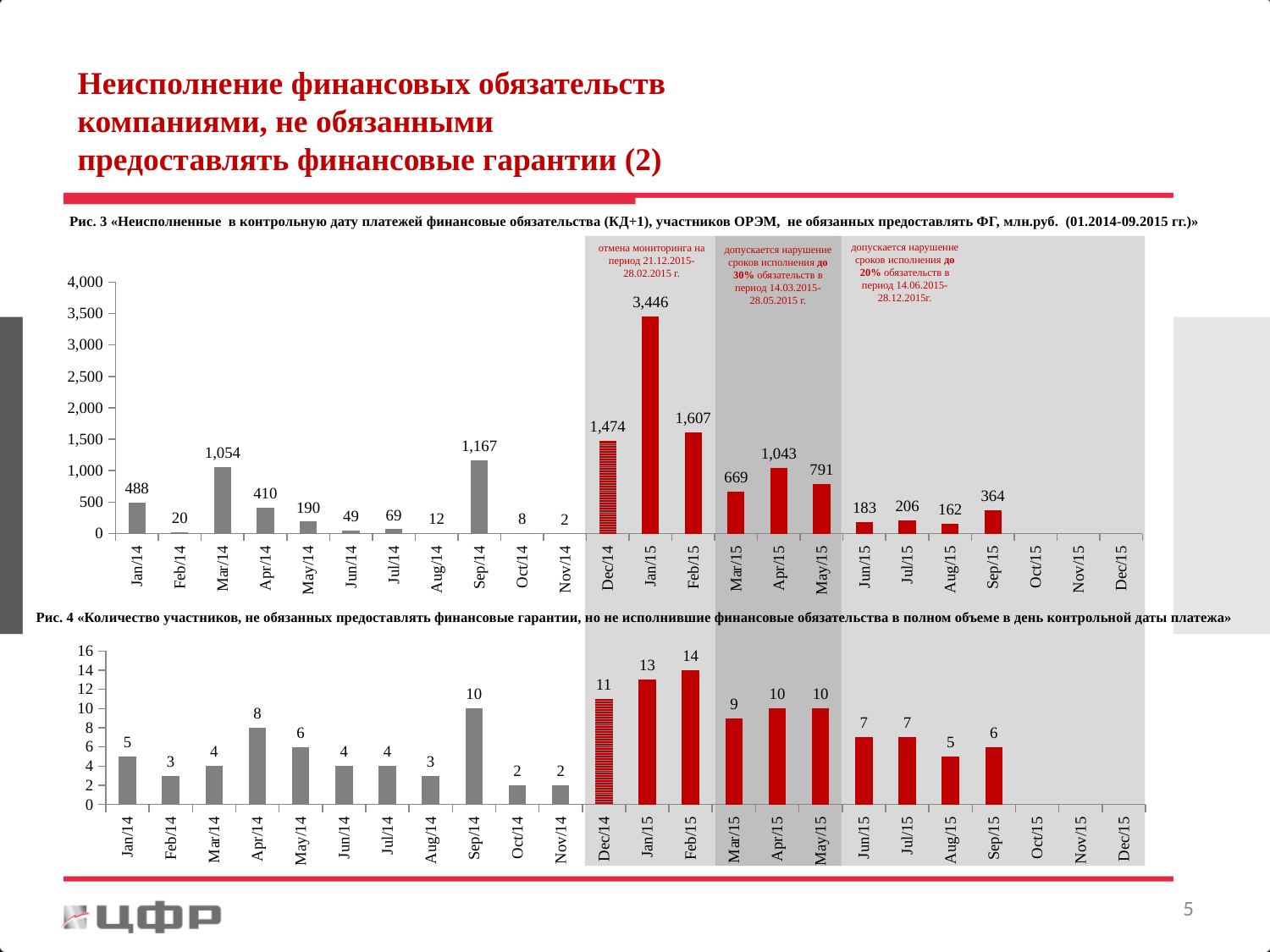
In the top chart (Рис. 3), what is the value for Jan/15? 3,446 In the bottom chart (Рис. 4), which month has the highest value? Feb/15 In the top chart (Рис. 3), which month has the lowest value among the months with a data label? Nov/14 In the bottom chart (Рис. 4), what is the difference between the values for Jan/15 and Mar/15? 4 What type of chart is the top chart (Рис. 3)? Bar chart In the top chart (Рис. 3), what is the difference between the values for Feb/15 and Dec/14? 133 In the top chart (Рис. 3), what is the value for Sep/14? 1,167 In the bottom chart (Рис. 4), what is the value for Sep/14? 10 In the top chart (Рис. 3), which is larger, the value for Mar/14 or the value for Apr/15? Mar/14 In the bottom chart (Рис. 4), what is the value for Feb/15? 14 In the top chart (Рис. 3), which month has the highest value? Jan/15 In the bottom chart (Рис. 4), do the values rise or fall from Dec/14 to Feb/15? Rise